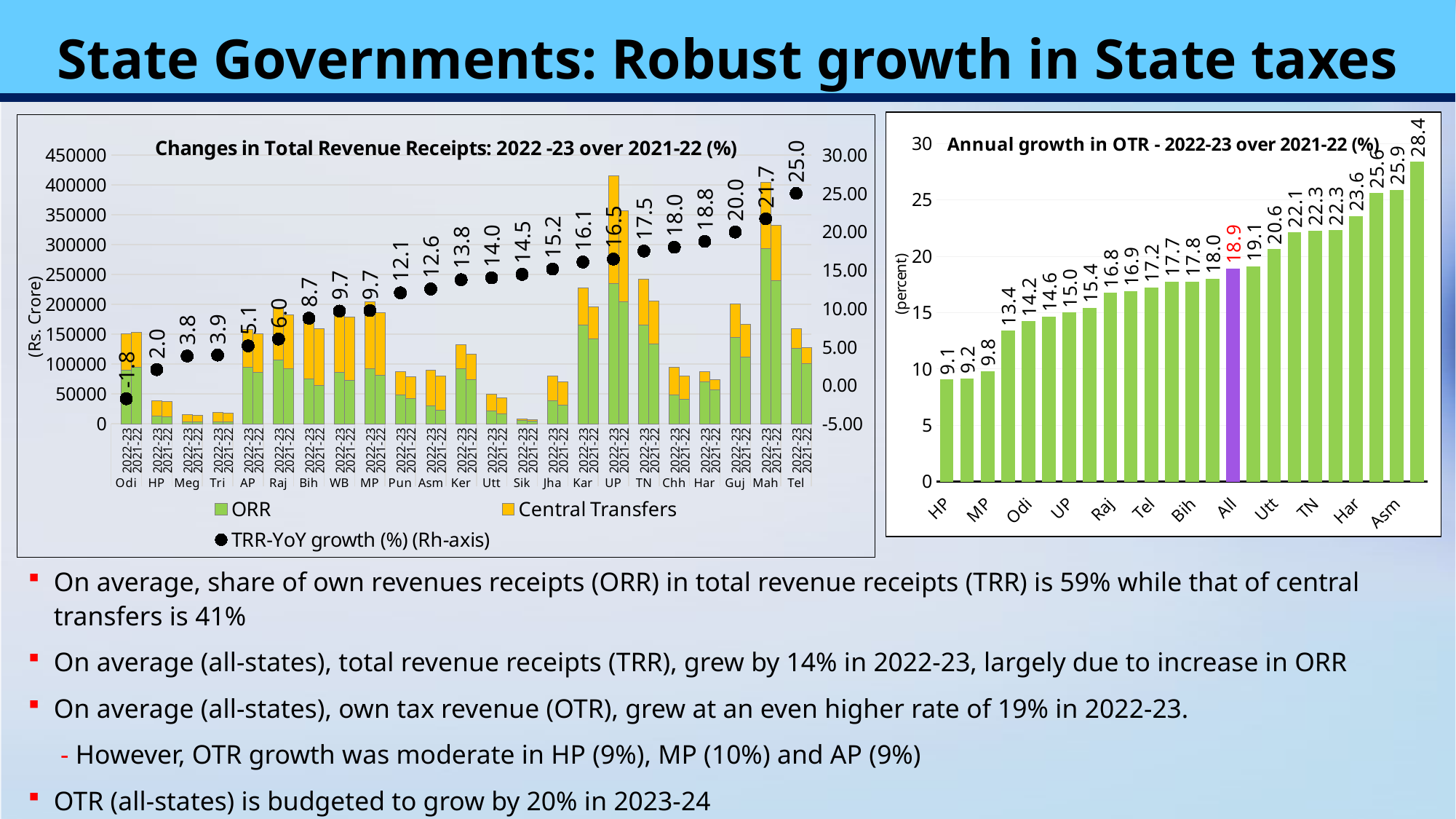
In the chart 'Changes in Total Revenue Receipts: 2022-23 over 2021-22 (%)', which has a higher TRR-YoY growth (%), Guj or Kar? Guj In the chart 'Annual growth in OTR - 2022-23 over 2021-22 (%)', what is the highest value shown? 28.4 What kind of chart is 'Annual growth in OTR - 2022-23 over 2021-22 (%)'? bar chart In the chart 'Changes in Total Revenue Receipts: 2022-23 over 2021-22 (%)', what is the TRR-YoY growth (%) for Odi? -1.8 In the chart 'Changes in Total Revenue Receipts: 2022-23 over 2021-22 (%)', how many states are shown on the x axis? 23 In the chart 'Changes in Total Revenue Receipts: 2022-23 over 2021-22 (%)', what is the TRR-YoY growth (%) for Tel? 25.0 In the chart 'Changes in Total Revenue Receipts: 2022-23 over 2021-22 (%)', how many series does the legend list? 3 In the chart 'Annual growth in OTR - 2022-23 over 2021-22 (%)', what is the value for All? 18.9 In the chart 'Changes in Total Revenue Receipts: 2022-23 over 2021-22 (%)', which state has the highest TRR-YoY growth (%)? Tel In the chart 'Changes in Total Revenue Receipts: 2022-23 over 2021-22 (%)', is the total 2022-23 bar for UP greater or less than 400000? greater In the chart 'Changes in Total Revenue Receipts: 2022-23 over 2021-22 (%)', which state has the lowest TRR-YoY growth (%)? Odi In the chart 'Changes in Total Revenue Receipts: 2022-23 over 2021-22 (%)', what is the difference between the TRR-YoY growth (%) of Mah and Guj? 1.7